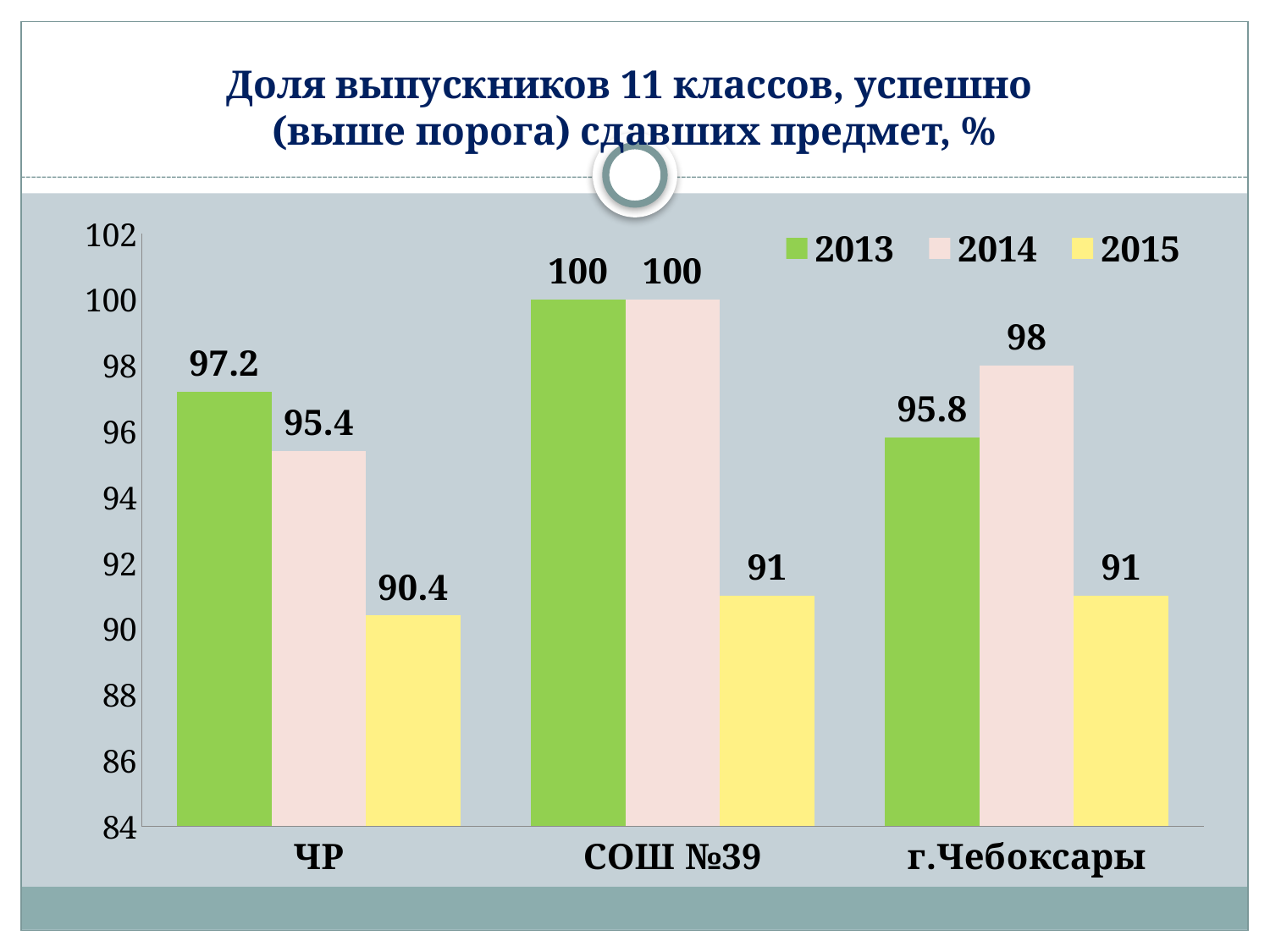
What is the difference between the 2014 values for СОШ №39 and г.Чебоксары? 2 Which category has the lowest value in 2015? ЧР What is the value for ЧР in 2013? 97.2 Which category has the highest value in 2013? СОШ №39 What kind of chart is shown on the slide? bar chart How many series does the legend list? 3 Do the values for СОШ №39 rise or fall from 2013 to 2015? fall What is the value for СОШ №39 in 2015? 91 What is the value for г.Чебоксары in 2014? 98 How many categories are shown on the x axis? 3 Which is larger: the 2013 value for ЧР or the 2013 value for г.Чебоксары? ЧР What is the difference between the 2013 and 2015 values for ЧР? 6.8